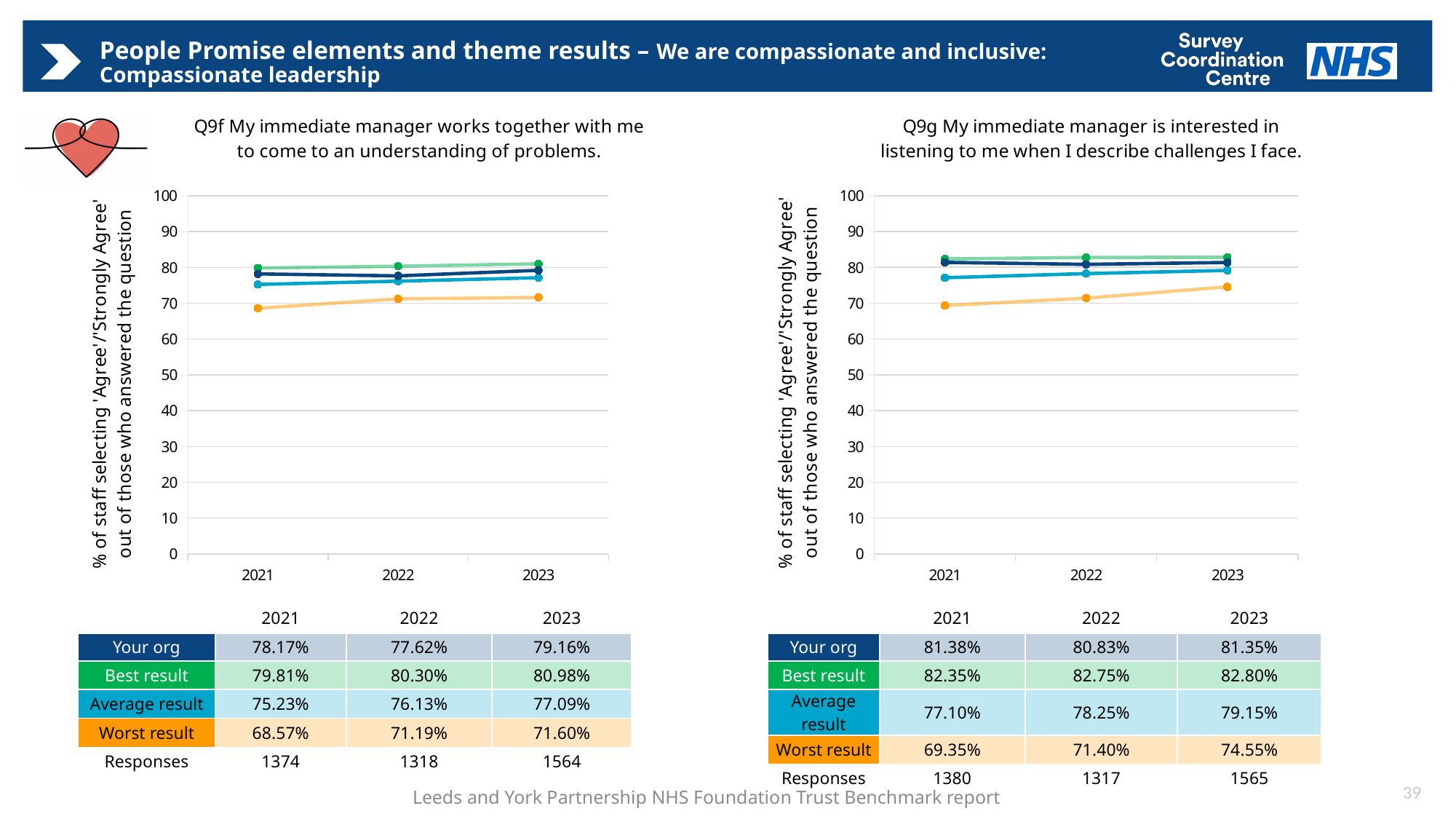
In the Q9g chart (right), what is the 'Worst result' value for 2021? 69.35% In the Q9g chart (right), which year has the highest 'Worst result' value? 2023 In the Q9f chart (left), does the 'Worst result' line rise or fall from 2021 to 2023? Rise How many series are shown in the Q9f chart (left), according to the table beneath it? 4 In the Q9f chart (left), what is the difference between the 'Best result' and 'Your org' values in 2023? 1.82 percentage points In the Q9g chart (right), what is the difference between the 'Worst result' values for 2023 and 2021? 5.20 percentage points In the Q9f chart (left), which year has the lowest 'Your org' value? 2022 What kind of chart is used for the Q9f results on the left? Line chart Which is larger: the 2023 'Average result' in the Q9g chart (right) or the 2023 'Average result' in the Q9f chart (left)? Q9g (79.15%) In the Q9f chart (left), what is the 'Your org' value for 2023? 79.16% How many years are plotted on the x axis of the Q9g chart (right)? 3 In the Q9f chart (left), is the 'Worst result' value for 2021 greater or less than 70? less